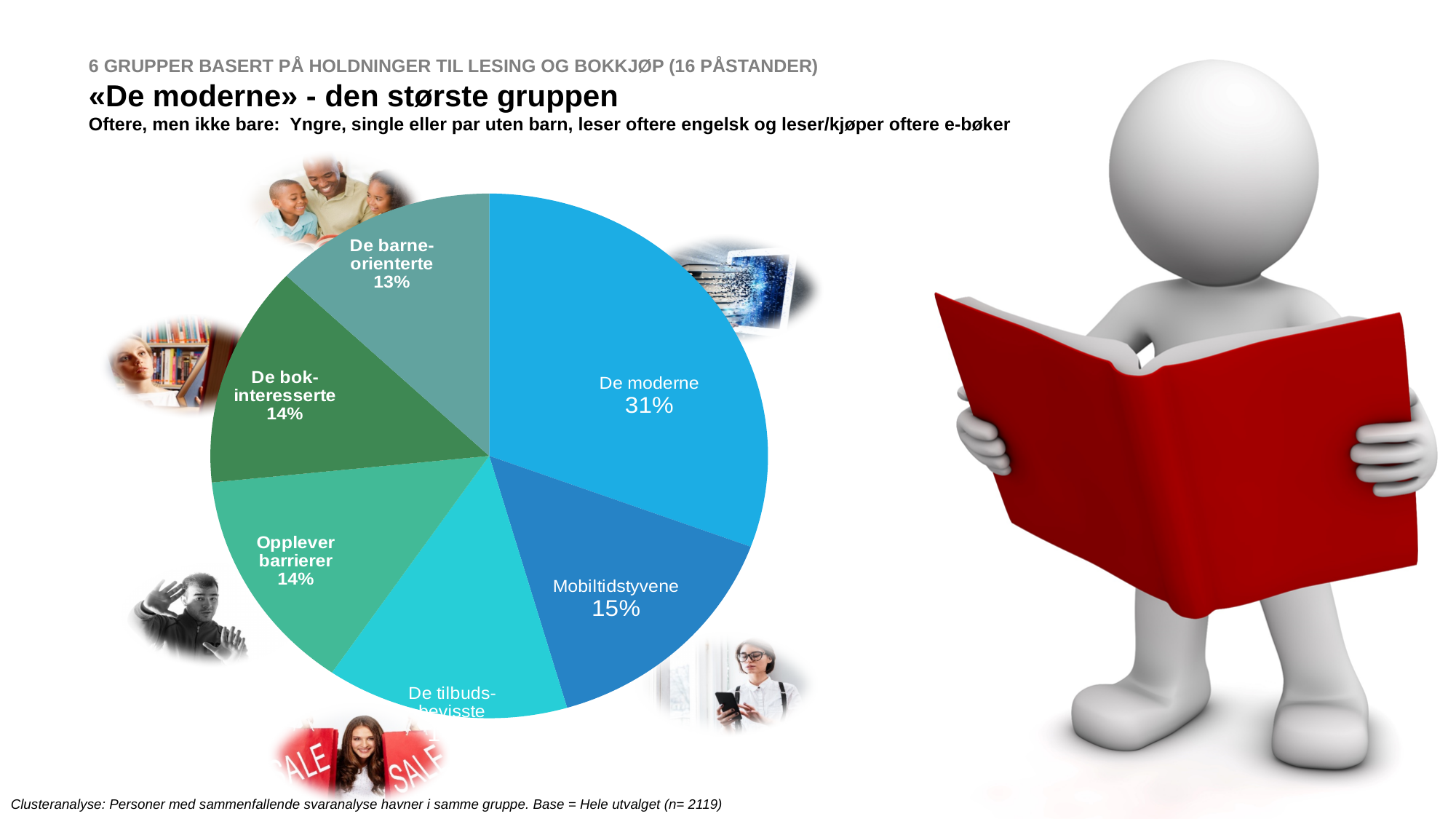
What is the difference in percentage points between "Mobiltidstyvene" and "De barne-orienterte"? 2 What is the value shown for "Mobiltidstyvene"? 15% How many slices does the pie chart have? 6 What is the value shown for "De barne-orienterte"? 13% Which is larger, the slice for "De moderne" or the slice for "Opplever barrierer"? De moderne What is the sample size (n) stated in the footnote of the slide? 2119 What is the difference in percentage points between "De moderne" and "Mobiltidstyvene"? 16 What share of the pie does the "De moderne" slice represent? 31% Which group has the largest slice of the pie? De moderne What is the value shown for "Opplever barrierer"? 14% What is the value shown for "De bok-interesserte"? 14% What kind of chart is shown on the slide? Pie chart